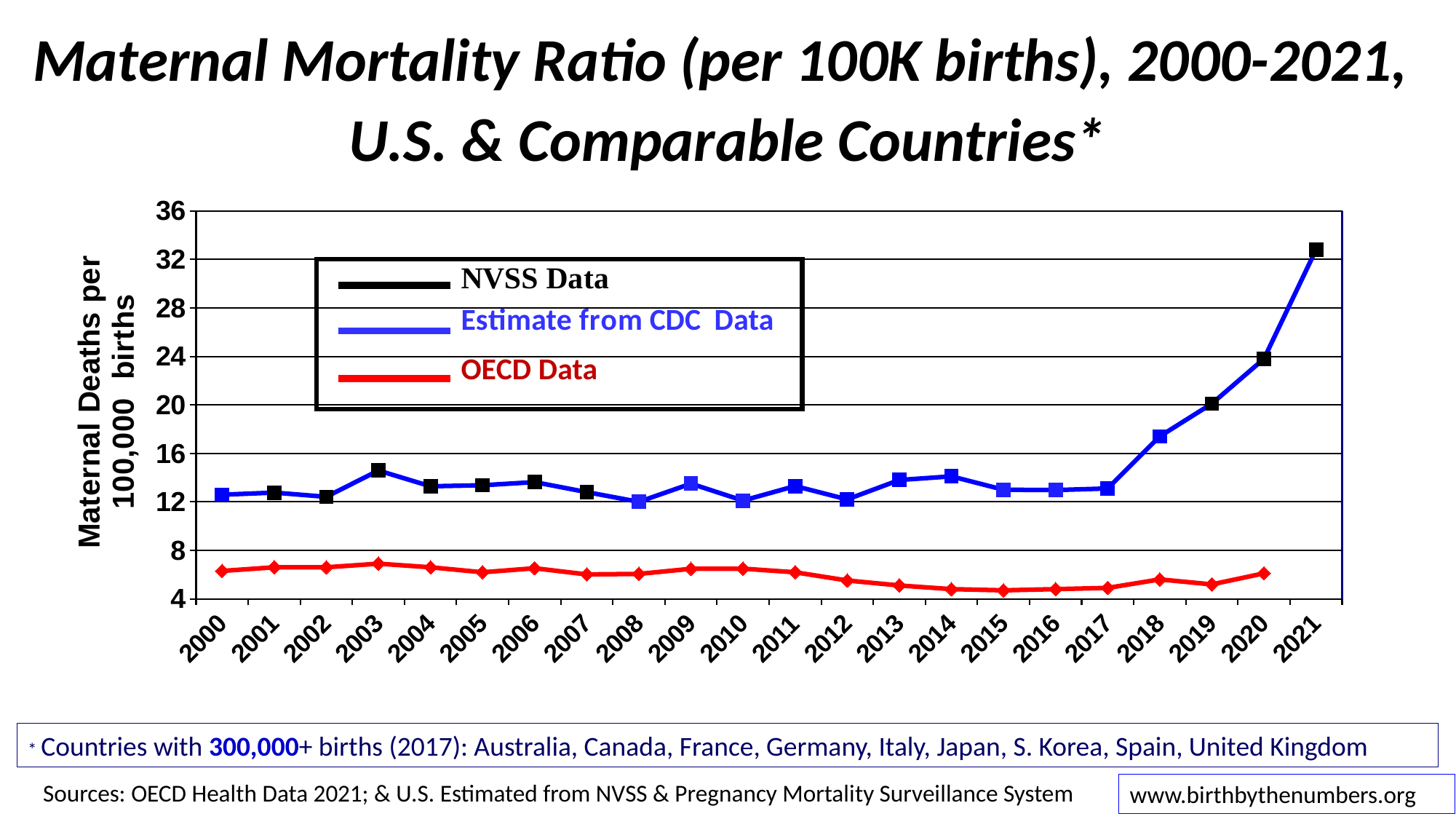
Is the NVSS Data value for 2019 greater or less than 24? less Is the NVSS Data value for 2021 greater or less than 32? greater What kind of chart is shown on the slide? line chart What colour is used for the OECD Data series? red In 2020, which is larger: the NVSS Data value or the OECD Data value? NVSS Data In which year does the NVSS Data series reach its highest value? 2021 Does the OECD Data series rise or fall from 2010 to 2015? fall How many series does the legend list? 3 Is the Estimate from CDC Data value for 2018 greater or less than 16? greater How many years are shown along the x axis? 22 Does the U.S. line (NVSS and CDC estimate) rise or fall from 2017 to 2021? rise